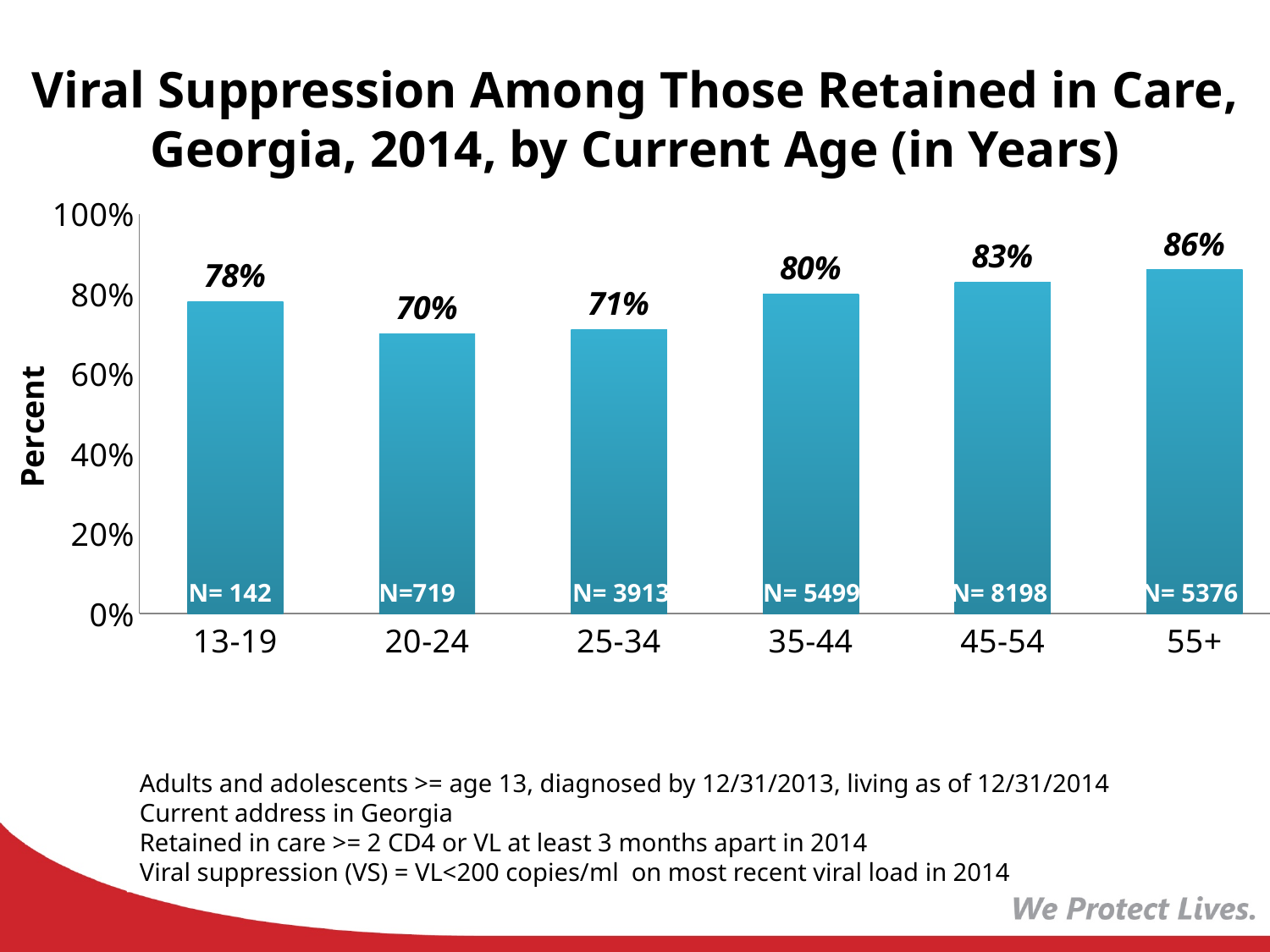
What type of chart is shown on the slide? Bar chart Which age group has a higher viral suppression percentage, 13-19 or 25-34? 13-19 What is the label on the y-axis of the chart? Percent Is the viral suppression percentage for the 45-54 age group greater or less than 80%? greater What is the difference in viral suppression percentage between the 55+ and 20-24 age groups? 16% What is the viral suppression percentage for the 55+ age group? 86% Which age group has the lowest viral suppression percentage? 20-24 What is the N value shown for the 45-54 age group? N= 8198 How many age groups are shown in the chart? 6 What is the viral suppression percentage for the 13-19 age group? 78% What is the viral suppression percentage for the 35-44 age group? 80% Which age group has the highest viral suppression percentage? 55+